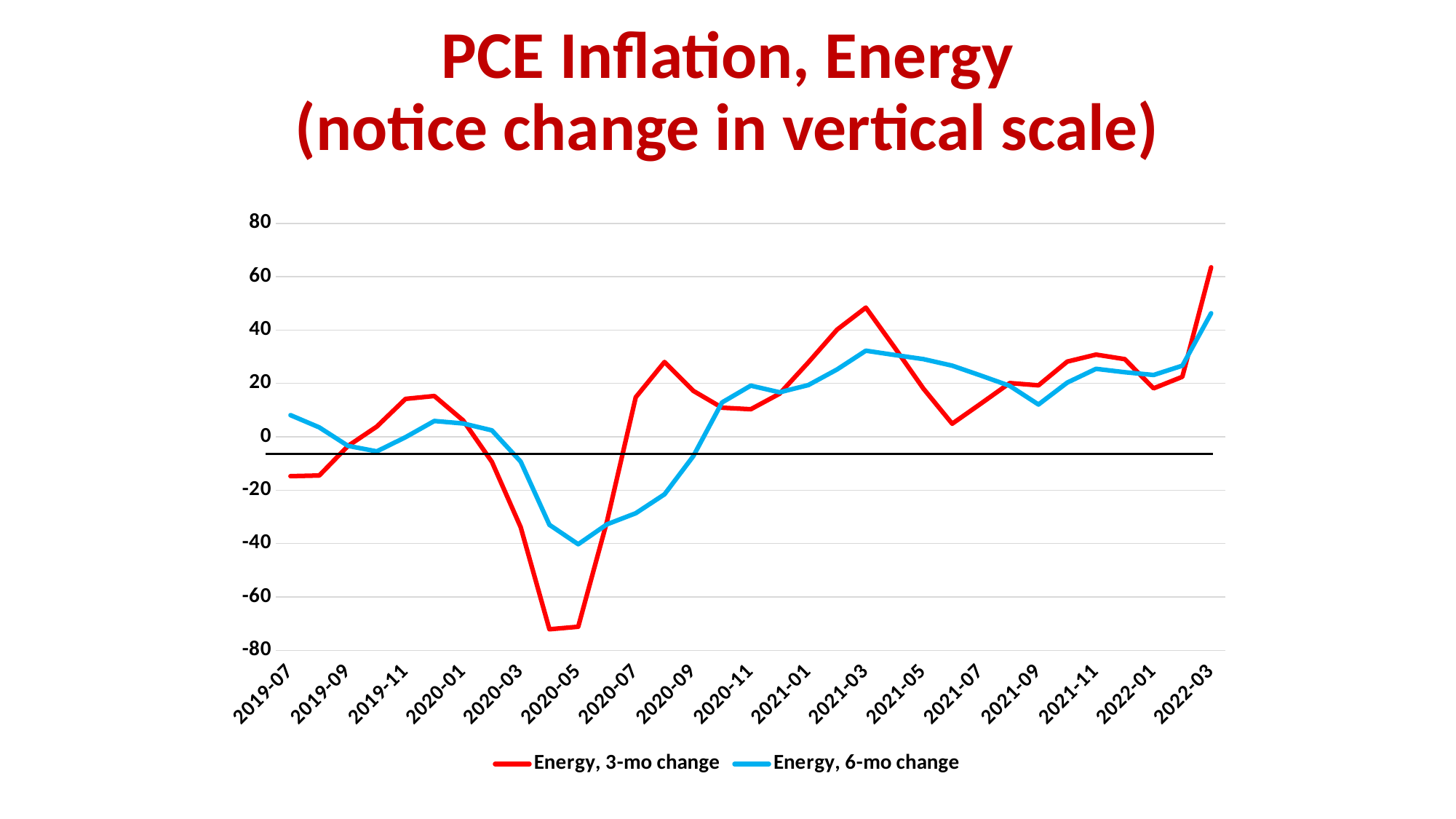
At which date does the Energy, 3-mo change series reach its highest value? 2022-03 Does the Energy, 3-mo change series rise or fall between 2021-03 and 2021-07? Fall At which date does the Energy, 6-mo change series reach its lowest value? 2020-05 How many series does the legend list? 2 At 2021-03, which series has the higher value, Energy, 3-mo change or Energy, 6-mo change? Energy, 3-mo change Is the value for Energy, 6-mo change at 2020-05 greater or less than -20? less What are the two series named in the legend? Energy, 3-mo change and Energy, 6-mo change Is the value for Energy, 3-mo change at 2020-05 greater or less than -60? less What kind of chart is shown on the slide? Line chart What colour is the line for Energy, 6-mo change? Blue At 2021-07, which series has the higher value, Energy, 3-mo change or Energy, 6-mo change? Energy, 6-mo change Is the value for Energy, 3-mo change at 2022-03 greater or less than 60? greater